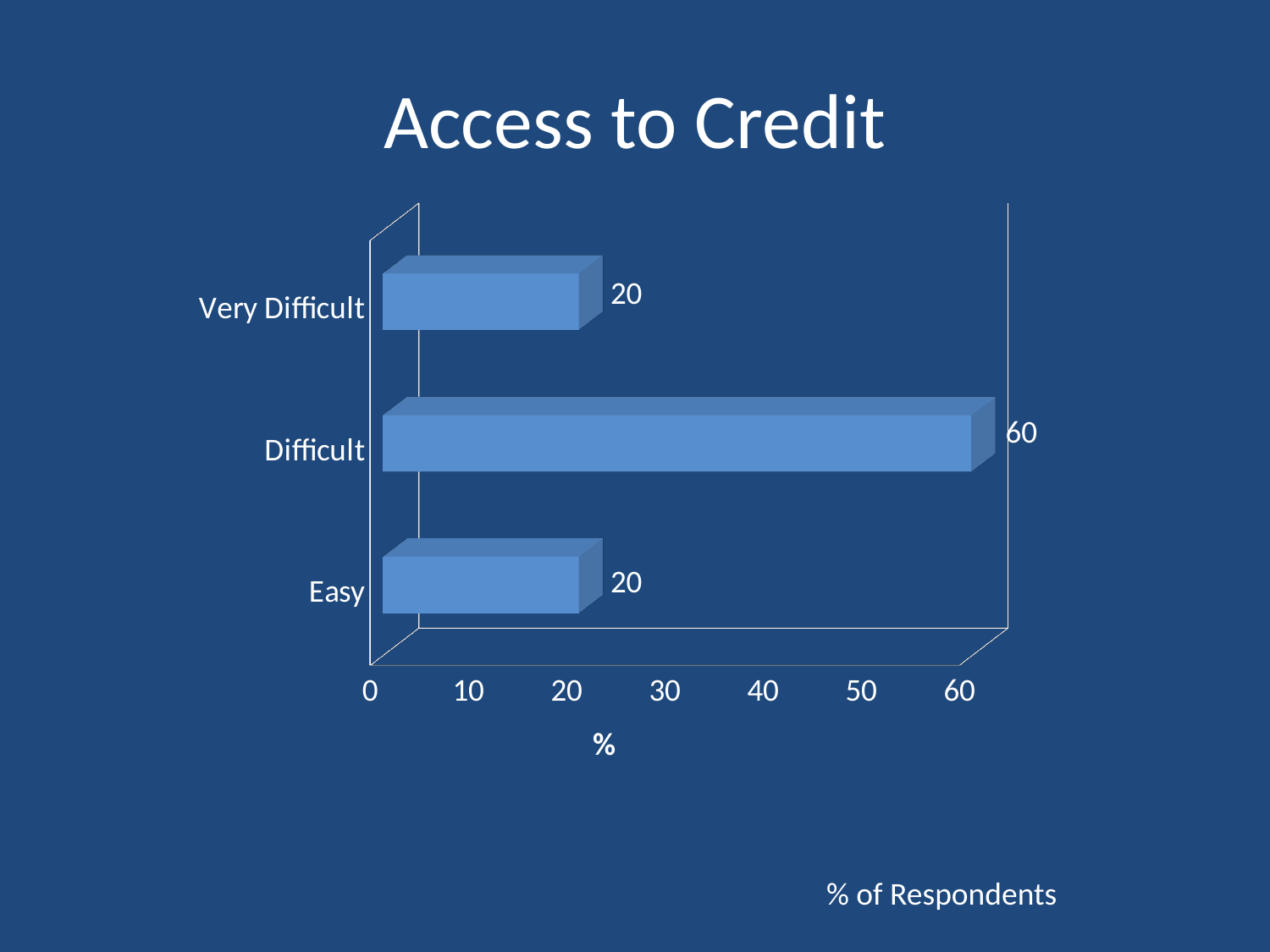
What is the value for Easy? 20 What kind of chart is shown on the slide? bar chart Which is larger, the value for Difficult or the value for Very Difficult? Difficult Is the value for Easy greater or less than 30? less What is the title of the chart? Access to Credit What is the value for Difficult? 60 What is the label on the horizontal axis? % How many categories are shown in the chart? 3 What is the value for Very Difficult? 20 Which category has the highest value? Difficult Is the value for Difficult greater or less than 50? greater What is the difference between the values for Difficult and Easy? 40